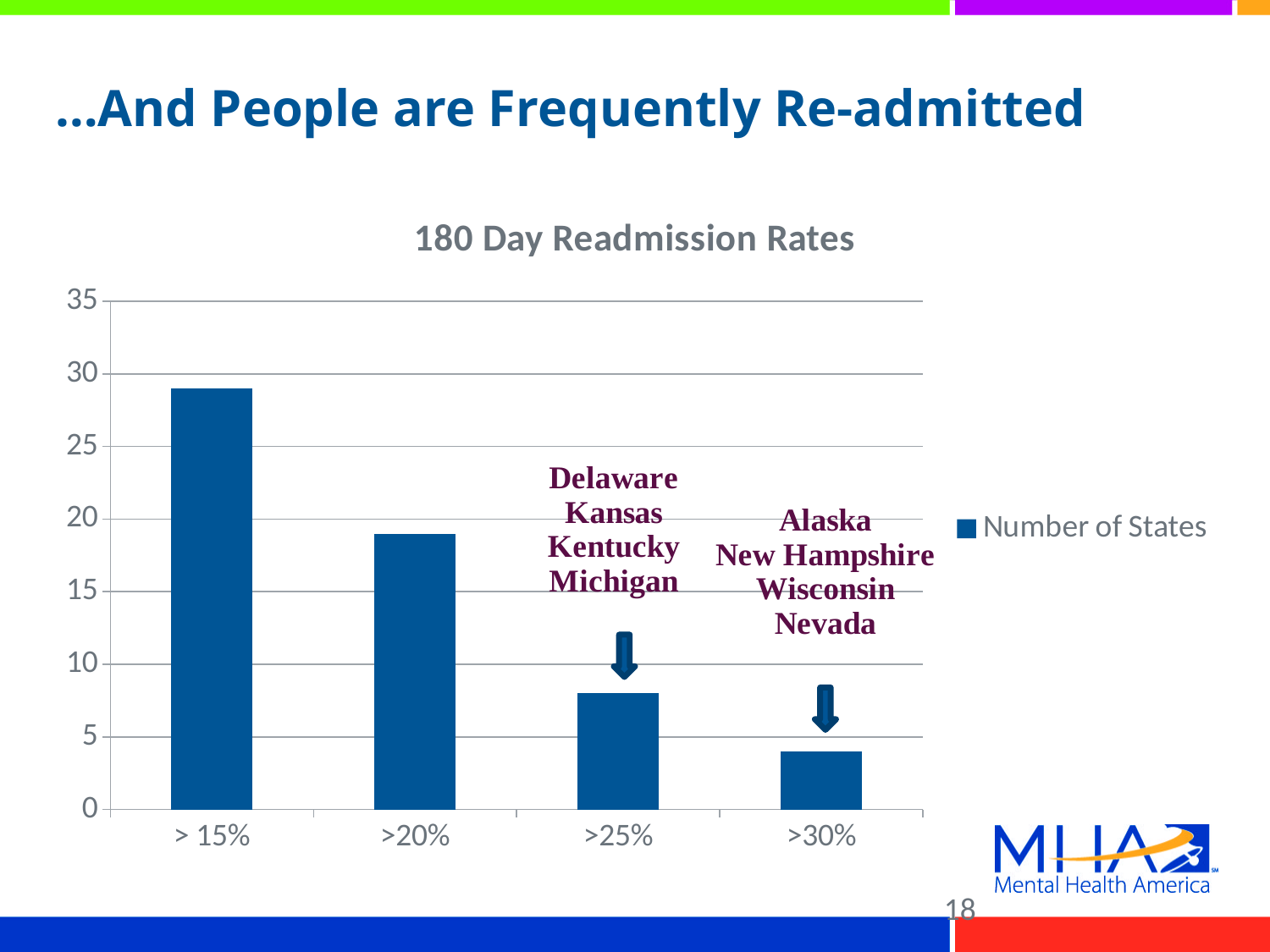
Is the value for >20% greater or less than 20? less How many series does the chart's legend list? 1 Is the value for > 15% greater or less than 25? greater Is the value for >25% greater or less than 10? less Which category has the highest number of states? > 15% Do the values rise or fall moving from > 15% to >30% along the x axis? fall What is the title of the chart? 180 Day Readmission Rates What kind of chart is shown on the slide? bar chart How many categories are shown on the x axis of the chart? 4 Which is larger, the value for >20% or the value for >25%? >20% What is the name of the series shown in the legend? Number of States Which category has the lowest number of states? >30%